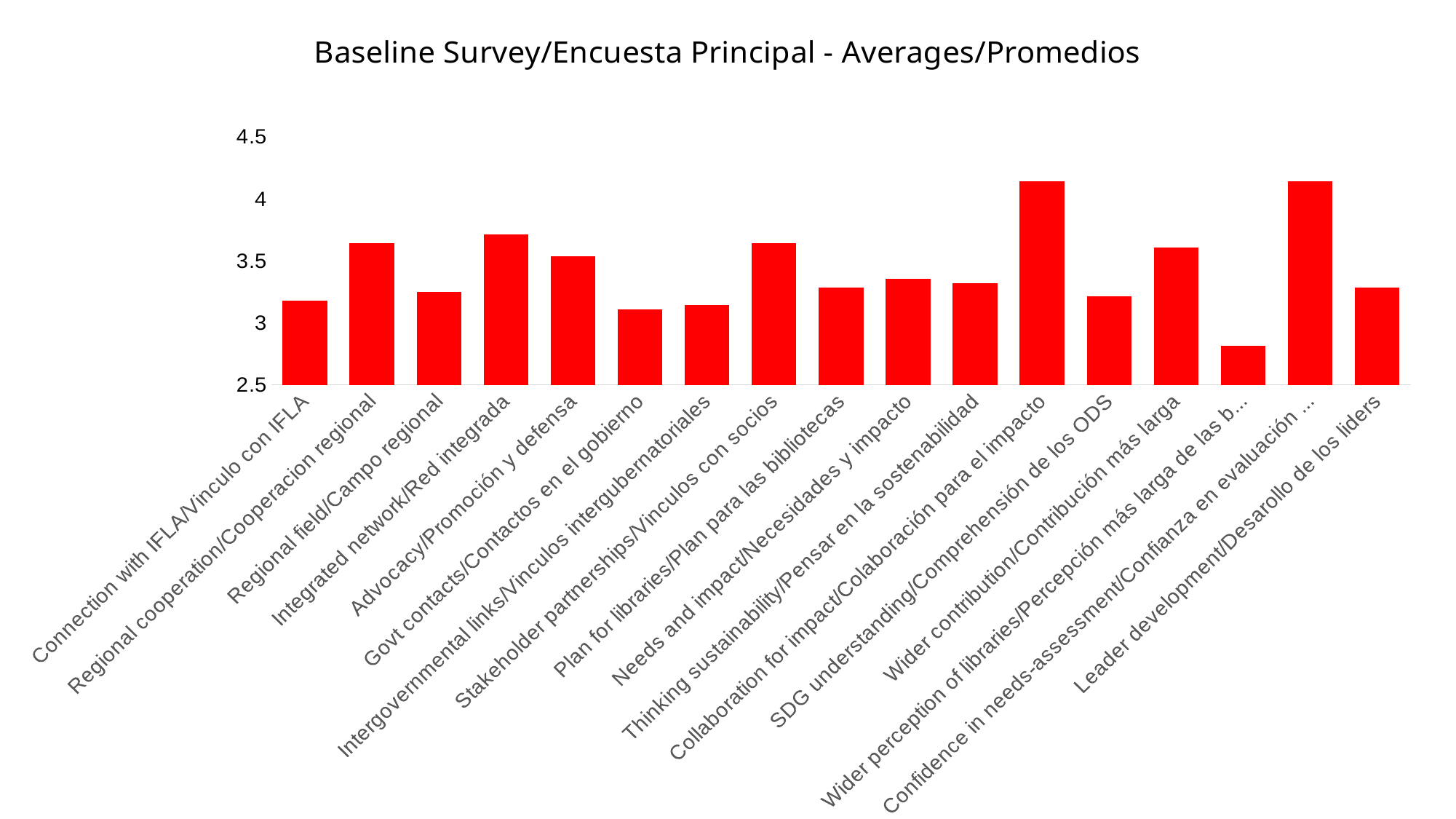
What is the title of the chart? Baseline Survey/Encuesta Principal - Averages/Promedios How many categories are plotted in the chart? 17 Which is larger: the value for Advocacy/Promoción y defensa or the value for Govt contacts/Contactos en el gobierno? Advocacy/Promoción y defensa Is the value for Confidence in needs-assessment greater or less than 4? greater What kind of chart is shown on the slide? bar chart Is the value for Wider perception of libraries greater or less than 3? less What colour are the bars in the chart? red Is the value for Collaboration for impact/Colaboración para el impacto greater or less than 4? greater Which category has the lowest value in the chart? Wider perception of libraries/Percepción más larga de las b... Which is larger: the value for Regional cooperation/Cooperacion regional or the value for Connection with IFLA/Vinculo con IFLA? Regional cooperation/Cooperacion regional